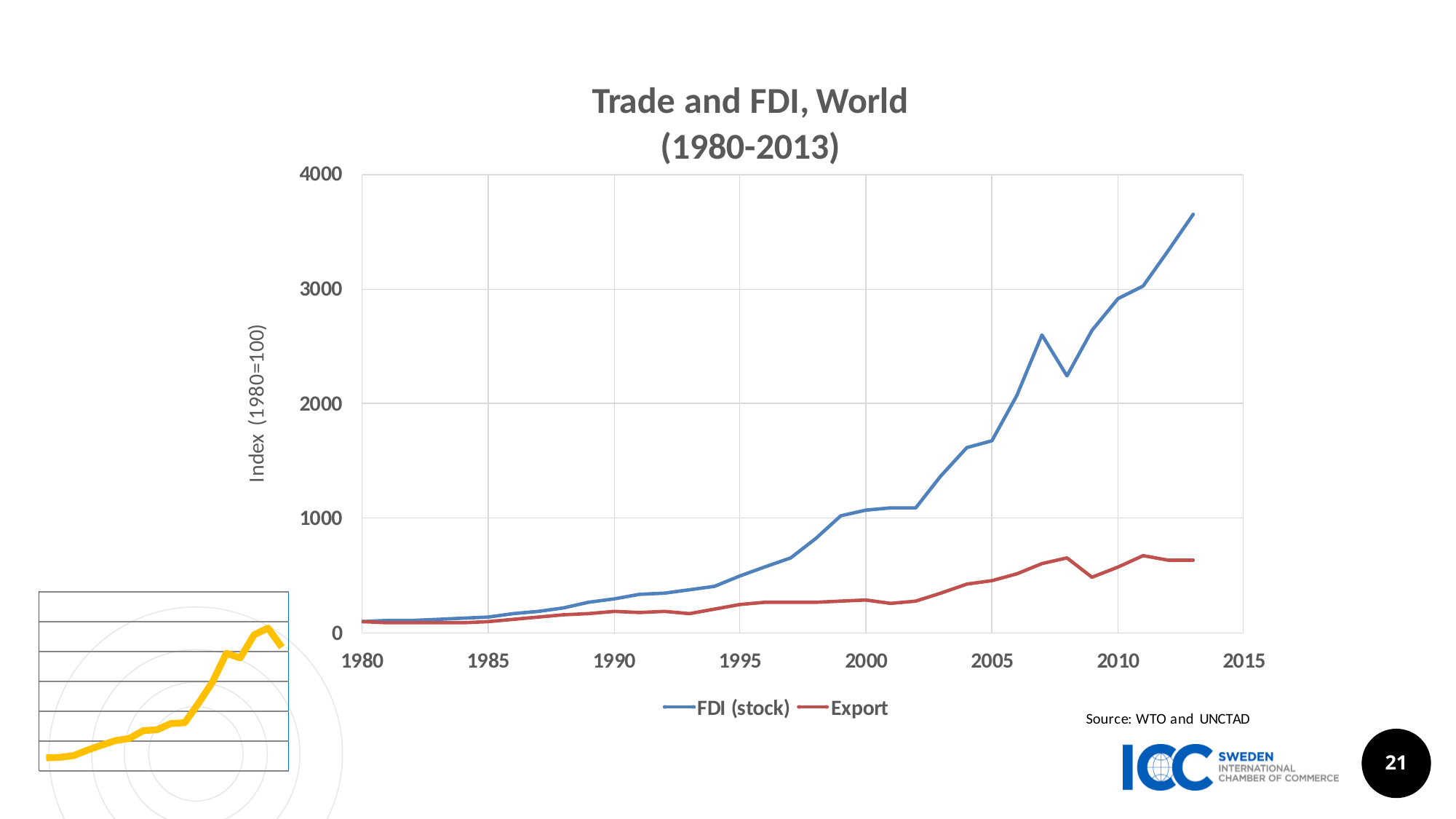
In the "Trade and FDI, World" chart, is the FDI (stock) value for 2007 greater or less than 2000? greater What are the two series named in the legend of the "Trade and FDI, World" chart? FDI (stock) and Export In the "Trade and FDI, World" chart, is the FDI (stock) value for 2013 greater or less than 3000? greater In the "Trade and FDI, World" chart, in which year does the FDI (stock) series reach its highest value? 2013 In the "Trade and FDI, World" chart, is the Export value for 1990 greater or less than 1000? less What is the y-axis label of the "Trade and FDI, World" chart? Index (1980=100) How many series does the legend of the "Trade and FDI, World" chart list? 2 What kind of chart is "Trade and FDI, World (1980-2013)"? line chart In the "Trade and FDI, World" chart, which series is higher in 2010, FDI (stock) or Export? FDI (stock) In the "Trade and FDI, World" chart, does the FDI (stock) series generally rise or fall from 1980 to 2013? rise